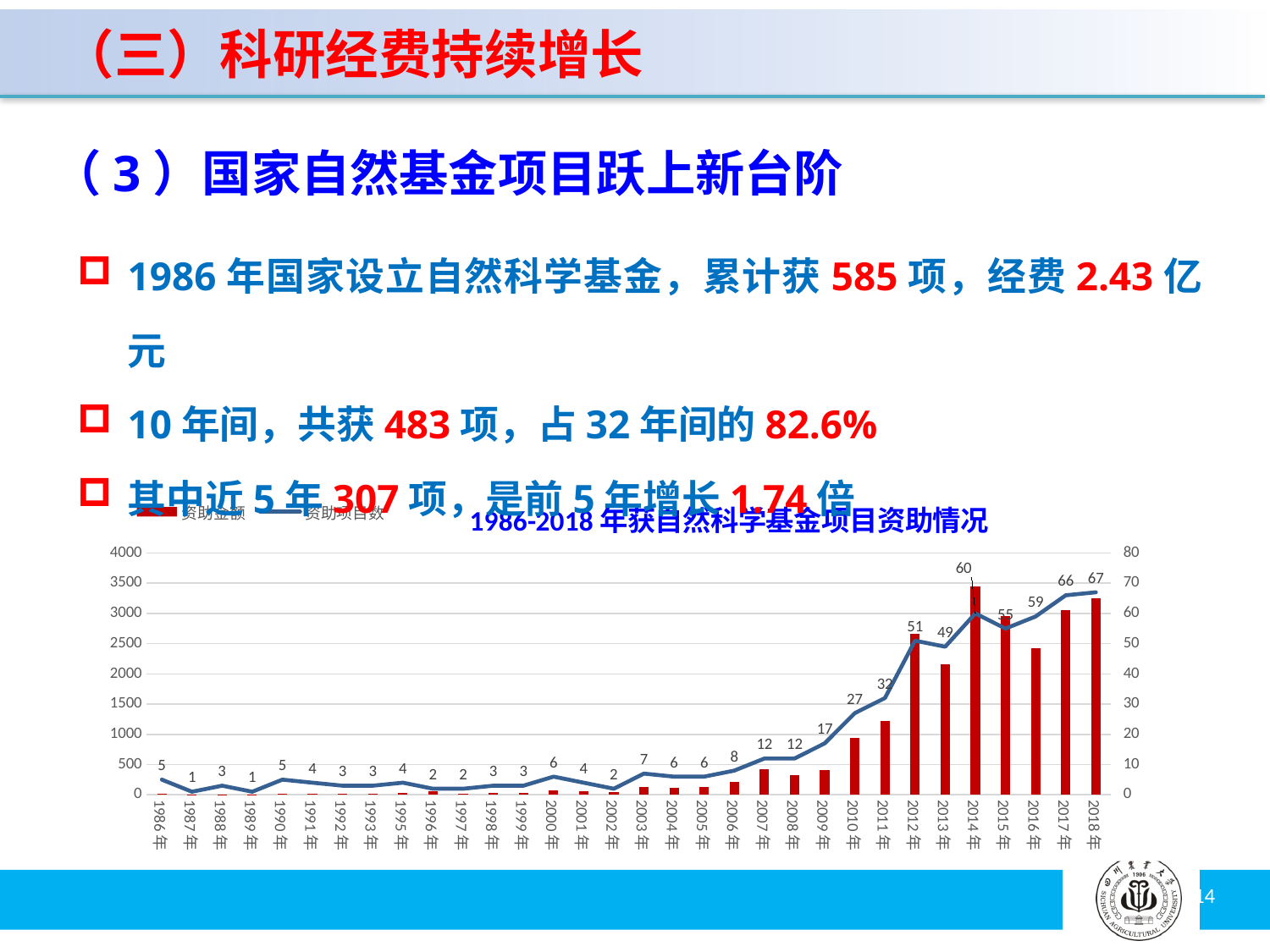
How many years are shown on the x axis of the chart? 32 What kind of chart is shown on the slide? Combined bar and line chart What is the value of 资助项目数 for 2010年? 27 What is the value of 资助项目数 for 2018年? 67 What is the value of 资助项目数 for 2014年? 60 Which year has the highest 资助项目数? 2018年 Is the 资助金额 bar for 2014年 greater or less than 3000? greater Which year has a larger 资助项目数, 2014年 or 2015年? 2014年 Which year has the tallest 资助金额 bar? 2014年 What is the difference in 资助项目数 between 2014年 and 2013年? 11 How many series does the chart legend list? 2